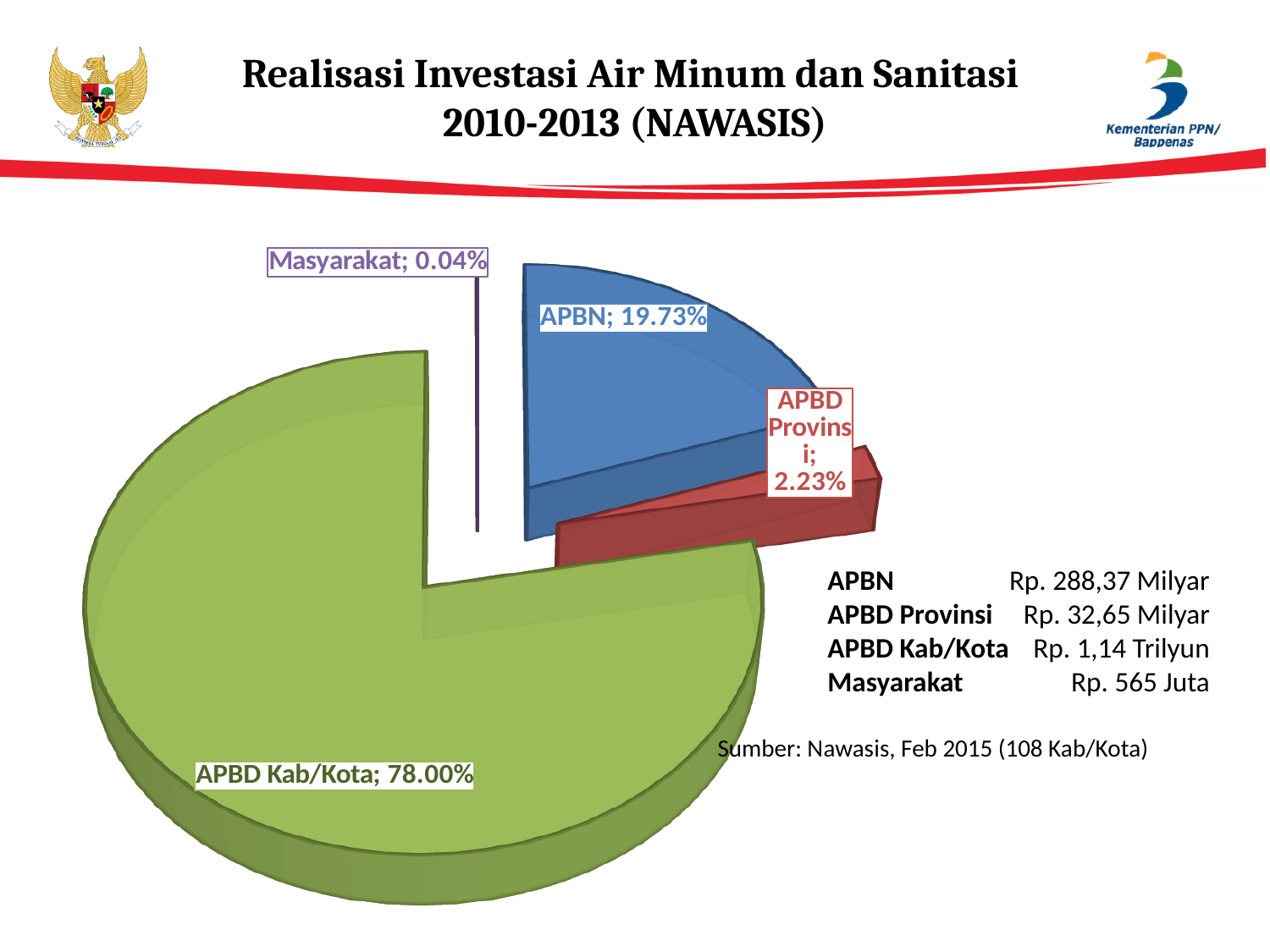
What share of the pie does APBD Kab/Kota hold? 78.00% What is the difference in percentage points between the APBD Kab/Kota and APBN slices? 58.27 What kind of chart is shown on the slide? pie chart How many slices does the pie chart have? 4 What colour is the APBD Kab/Kota slice? green Which slice is larger, APBN or APBD Provinsi? APBN What share of the pie does Masyarakat hold? 0.04% Which category has the largest slice of the pie? APBD Kab/Kota What share of the pie does APBN hold? 19.73% What is the difference in percentage points between the APBD Provinsi and Masyarakat slices? 2.19 Which category has the smallest slice of the pie? Masyarakat